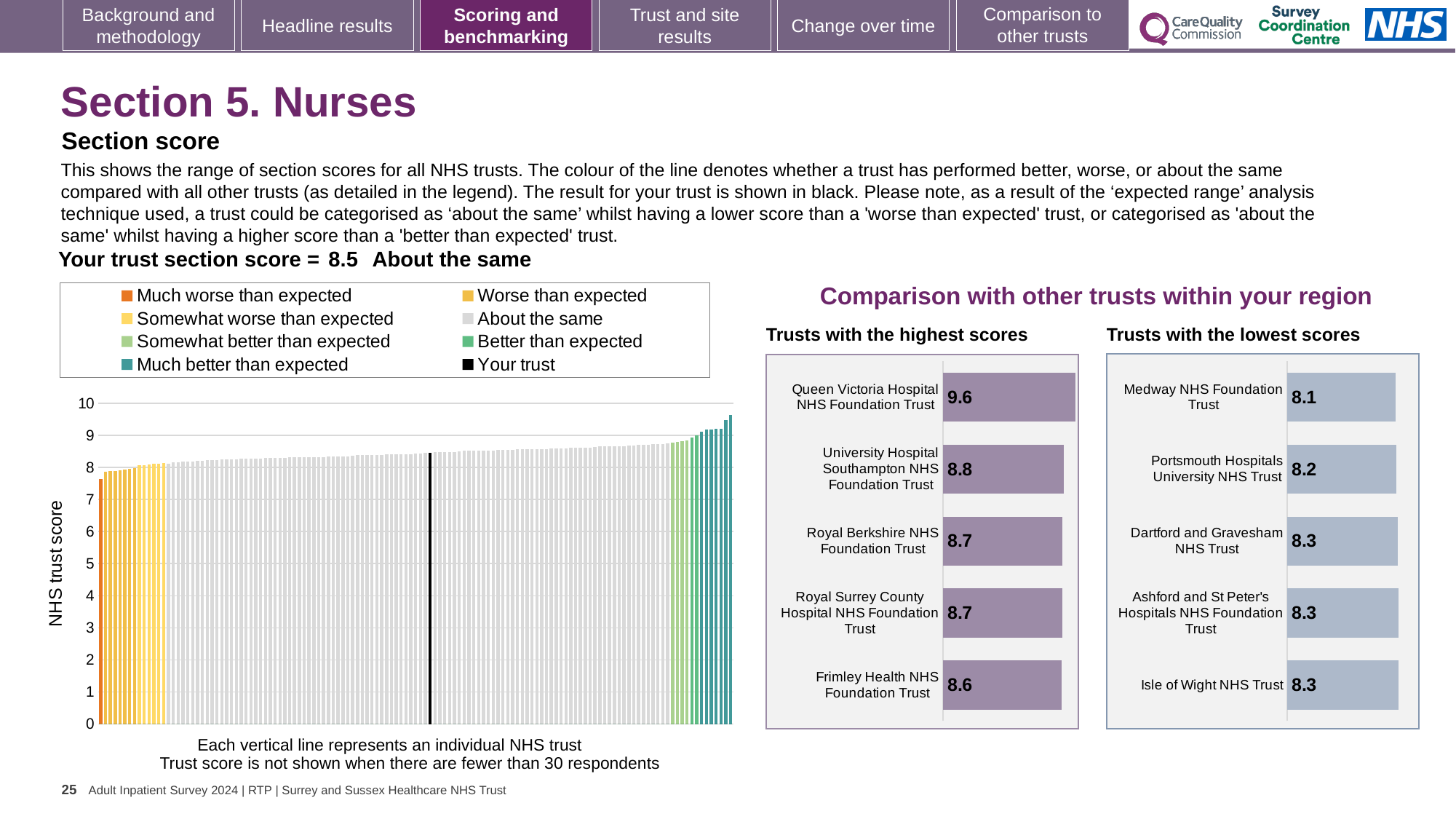
In the 'Trusts with the lowest scores' chart, what is the score for Portsmouth Hospitals University NHS Trust? 8.2 In the 'Trusts with the lowest scores' chart, which has the larger score: Medway NHS Foundation Trust or Dartford and Gravesham NHS Trust? Dartford and Gravesham NHS Trust In the 'Trusts with the lowest scores' chart, which trust has the lowest score? Medway NHS Foundation Trust In the 'Trusts with the highest scores' chart, what is the score for Frimley Health NHS Foundation Trust? 8.6 In the 'Trusts with the highest scores' chart, what is the difference between the scores of Queen Victoria Hospital NHS Foundation Trust and University Hospital Southampton NHS Foundation Trust? 0.8 In the 'Trusts with the lowest scores' chart, what is the score for Medway NHS Foundation Trust? 8.1 In the 'Trusts with the highest scores' chart, what is the score for Queen Victoria Hospital NHS Foundation Trust? 9.6 How many trusts are shown in the 'Trusts with the highest scores' chart? 5 In the 'Trusts with the highest scores' chart, which trust has the highest score? Queen Victoria Hospital NHS Foundation Trust In the left-hand chart of all NHS trusts, is the value for the black 'Your trust' bar greater or less than 8? greater How many entries does the legend of the left-hand chart of all NHS trusts list? 8 What kind of chart is the 'Trusts with the lowest scores' chart? Bar chart